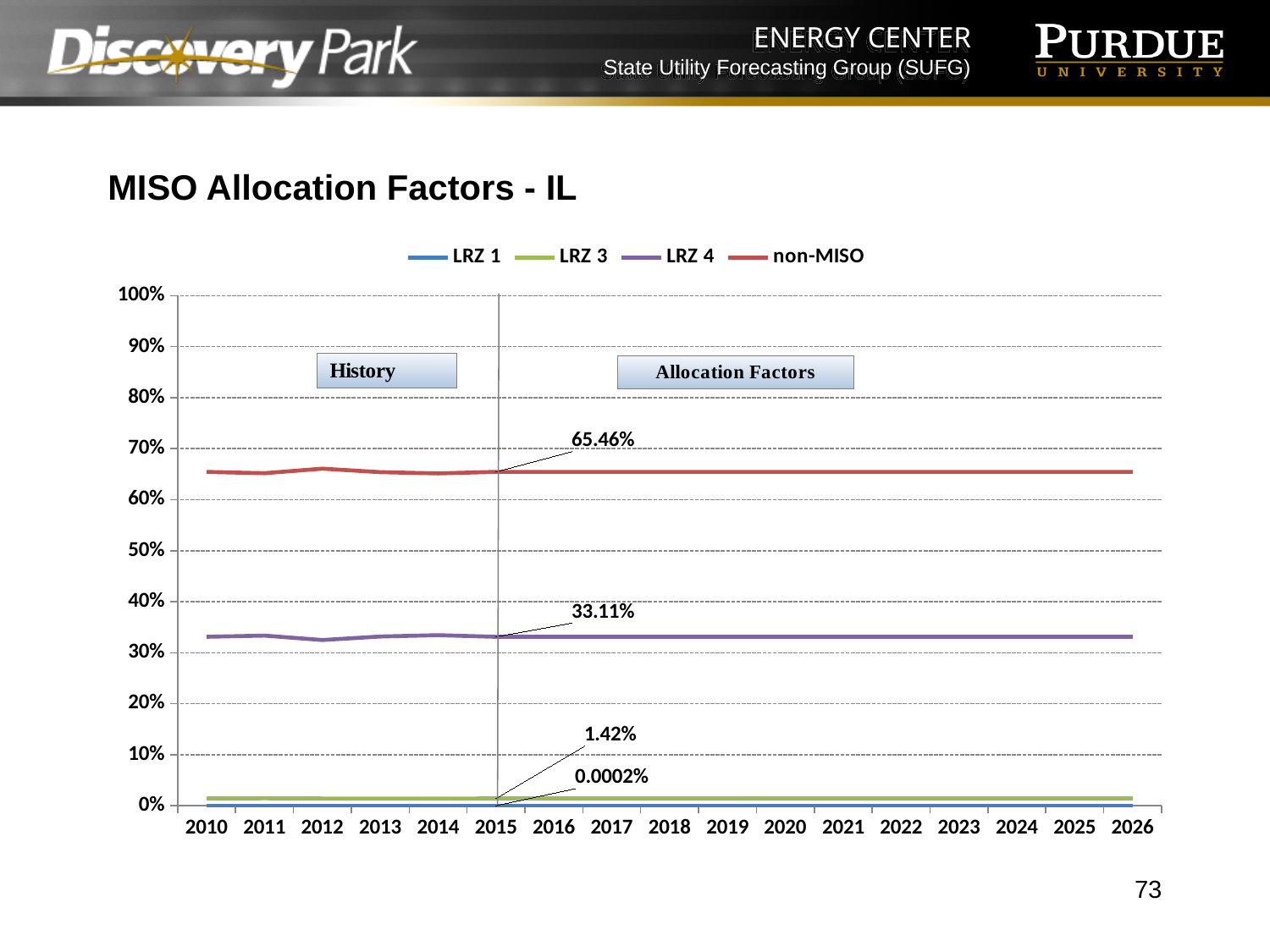
Which series has the highest allocation factor? non-MISO What is the labelled allocation factor for LRZ 3 at 2015? 1.42% What is the labelled allocation factor for LRZ 4 at 2015? 33.11% Is the value for LRZ 4 in 2020 greater or less than 40%? less Which series has the lowest allocation factor? LRZ 1 What kind of chart is shown on the slide? line chart What is the labelled allocation factor for LRZ 1 at 2015? 0.0002% How many series does the legend list? 4 What is the difference between the labelled non-MISO value and the labelled LRZ 4 value at 2015? 32.35% What is the labelled allocation factor for non-MISO at 2015? 65.46% What is the title of the chart? MISO Allocation Factors - IL How many years are shown on the x axis? 17